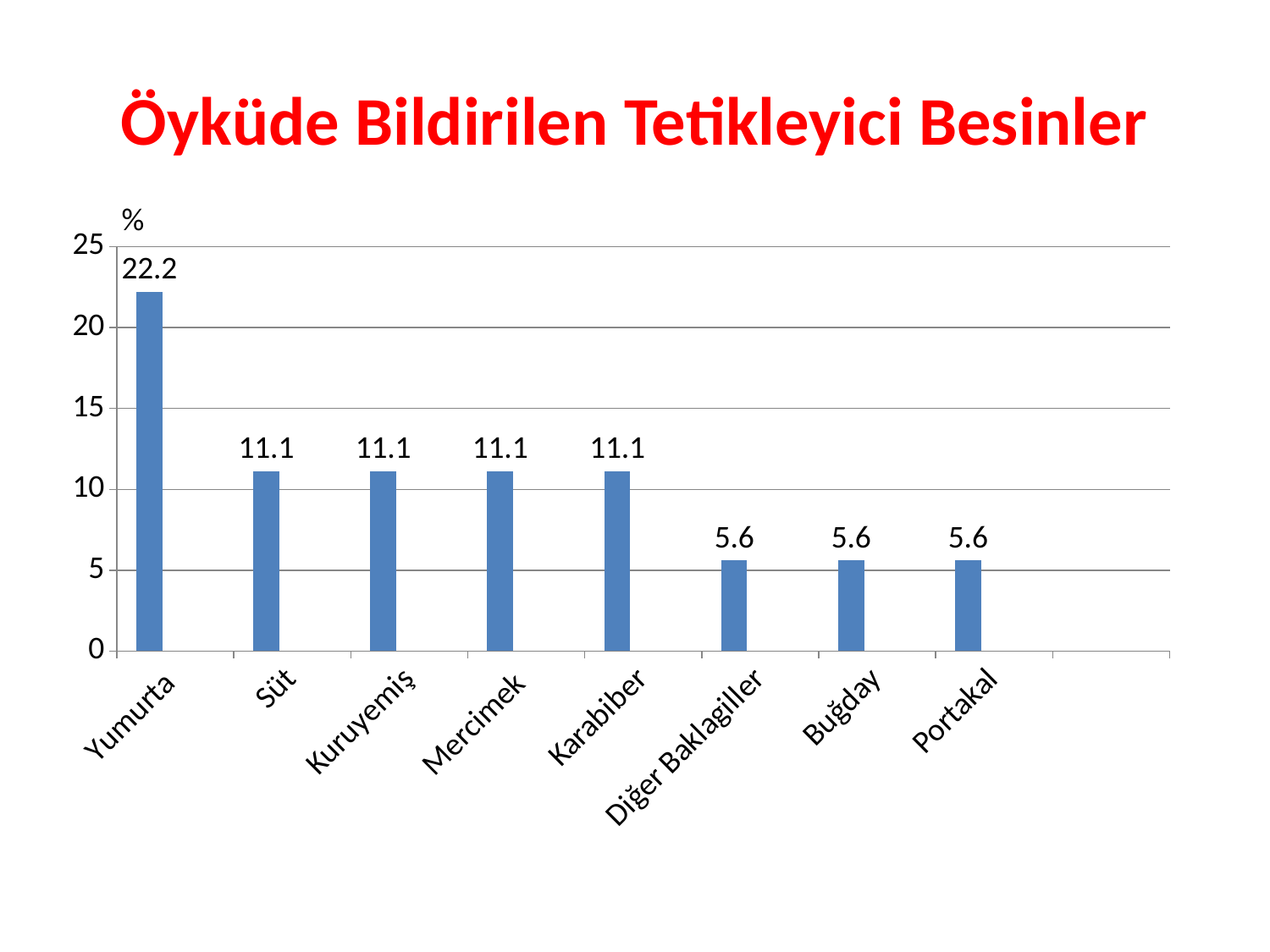
What is the value for Buğday? 5.6 How many categories are shown on the x axis? 8 What is the value for Yumurta? 22.2 Is the value for Yumurta greater or less than 20? greater What is the value for Süt? 11.1 What is the difference between the values for Yumurta and Mercimek? 11.1 Which is larger, the value for Kuruyemiş or the value for Portakal? Kuruyemiş What kind of chart is shown on the slide? bar chart What is the title of the slide? Öyküde Bildirilen Tetikleyici Besinler What is the difference between the values for Karabiber and Portakal? 5.5 Which category has the highest value? Yumurta What is the value for Diğer Baklagiller? 5.6